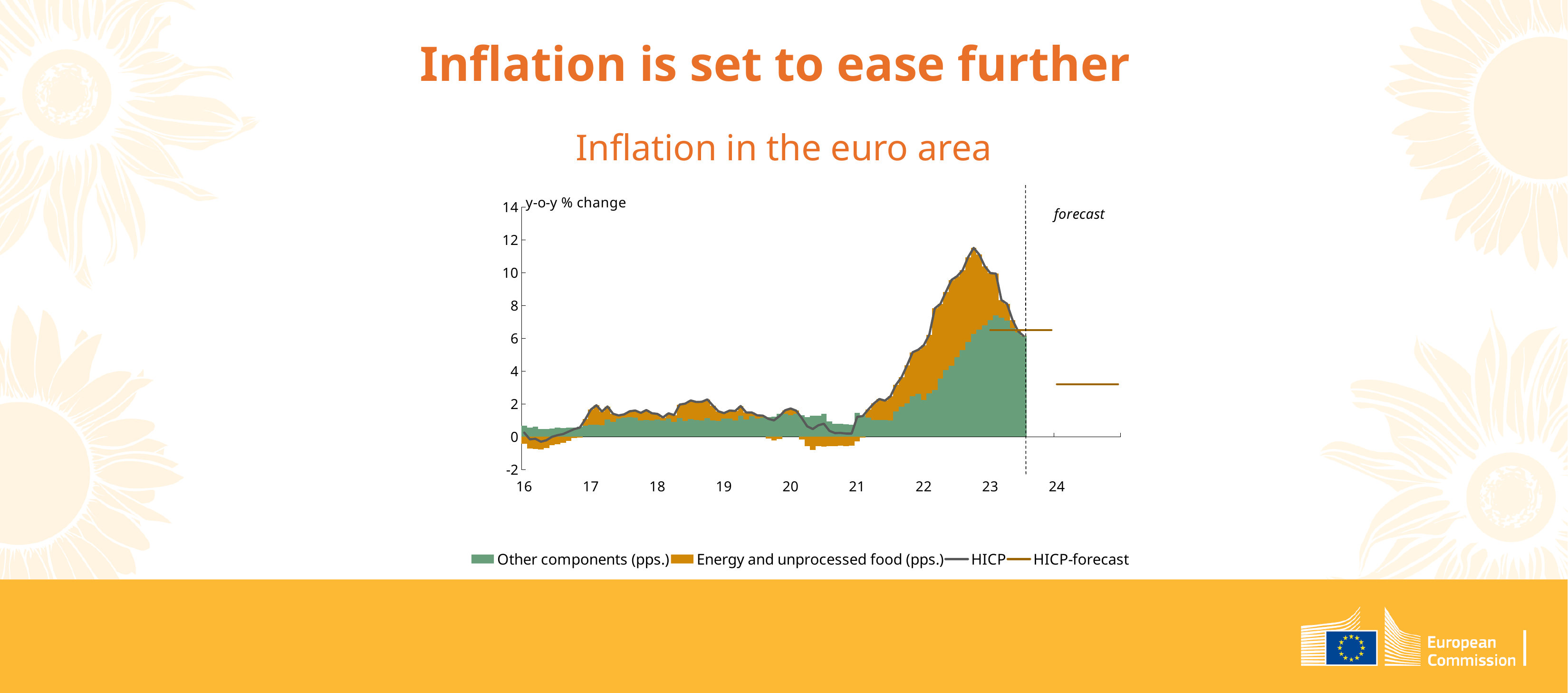
Is the peak value of the HICP line in late 2022 greater or less than 10? greater Is the HICP-forecast value for 2023 greater or less than 6? greater What is the label on the y axis of the chart? y-o-y % change Is the HICP value at the start of 2016 greater or less than 1? less What is the title of the chart? Inflation in the euro area How many series does the chart legend list? 4 Does the HICP line rise or fall from its late-2022 peak to mid-2023? fall In the last bar before the forecast line, which component is larger: Other components or Energy and unprocessed food? Other components What kind of chart is shown on the slide? Stacked bar chart with line series Which is higher, the HICP-forecast for 2023 or for 2024? 2023 How many year labels are shown on the x axis? 9